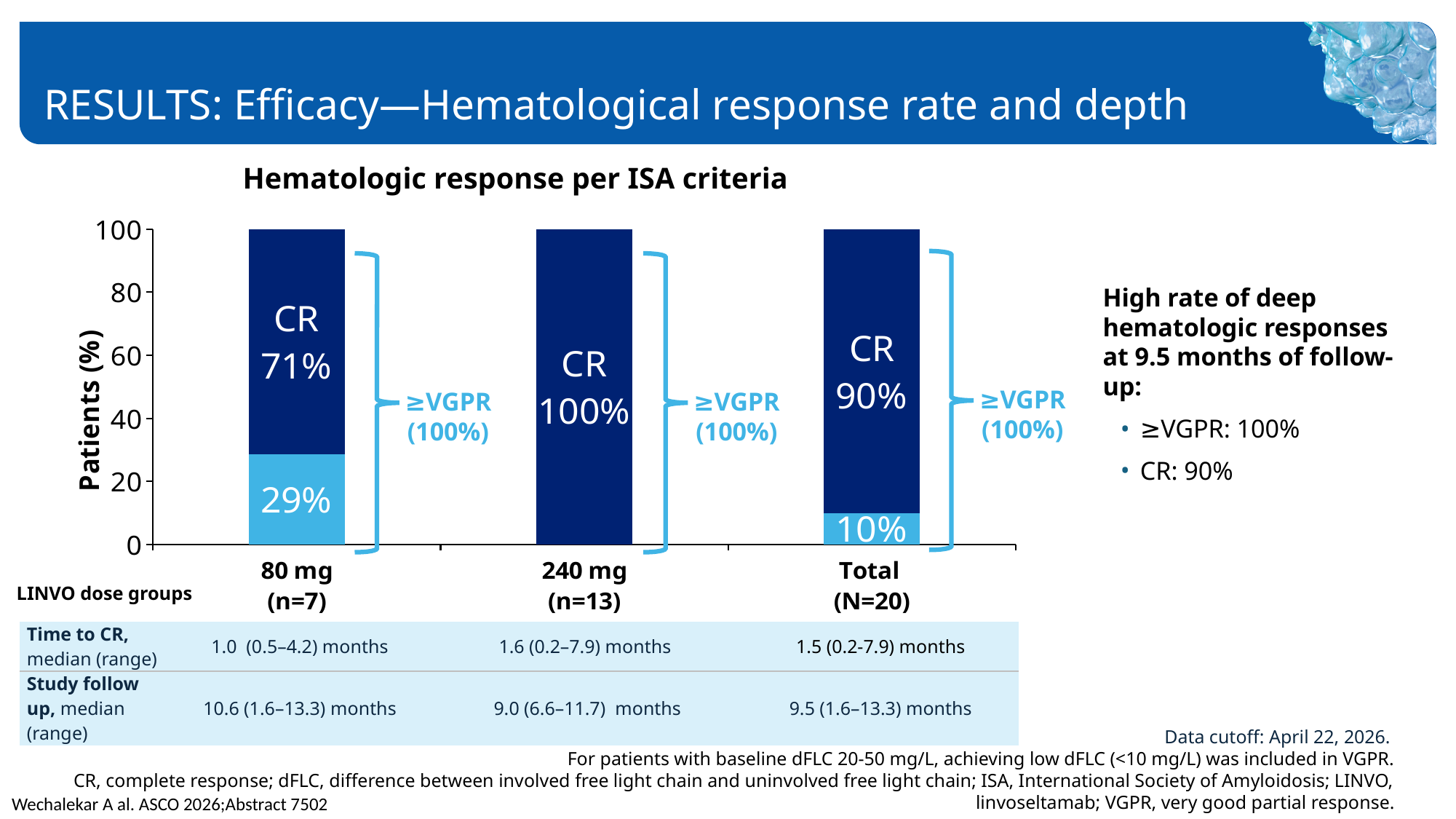
What type of chart is used to show hematologic response? Stacked bar chart Which dose group has the lowest CR rate? 80 mg Is the CR rate higher for the 80 mg group or the Total group? Total How many dose groups are shown on the x axis? 3 Which dose group has the highest CR rate? 240 mg What is the CR rate for the 240 mg dose group? 100% What is the CR rate for the 80 mg dose group? 71% What percentage is shown in the light blue segment of the Total bar? 10% What is the difference in CR rate between the 240 mg group and the 80 mg group? 29% What is the CR rate for the Total group? 90% What percentage is shown in the light blue segment of the 80 mg bar? 29% What is the ≥VGPR rate shown for the Total group? 100%